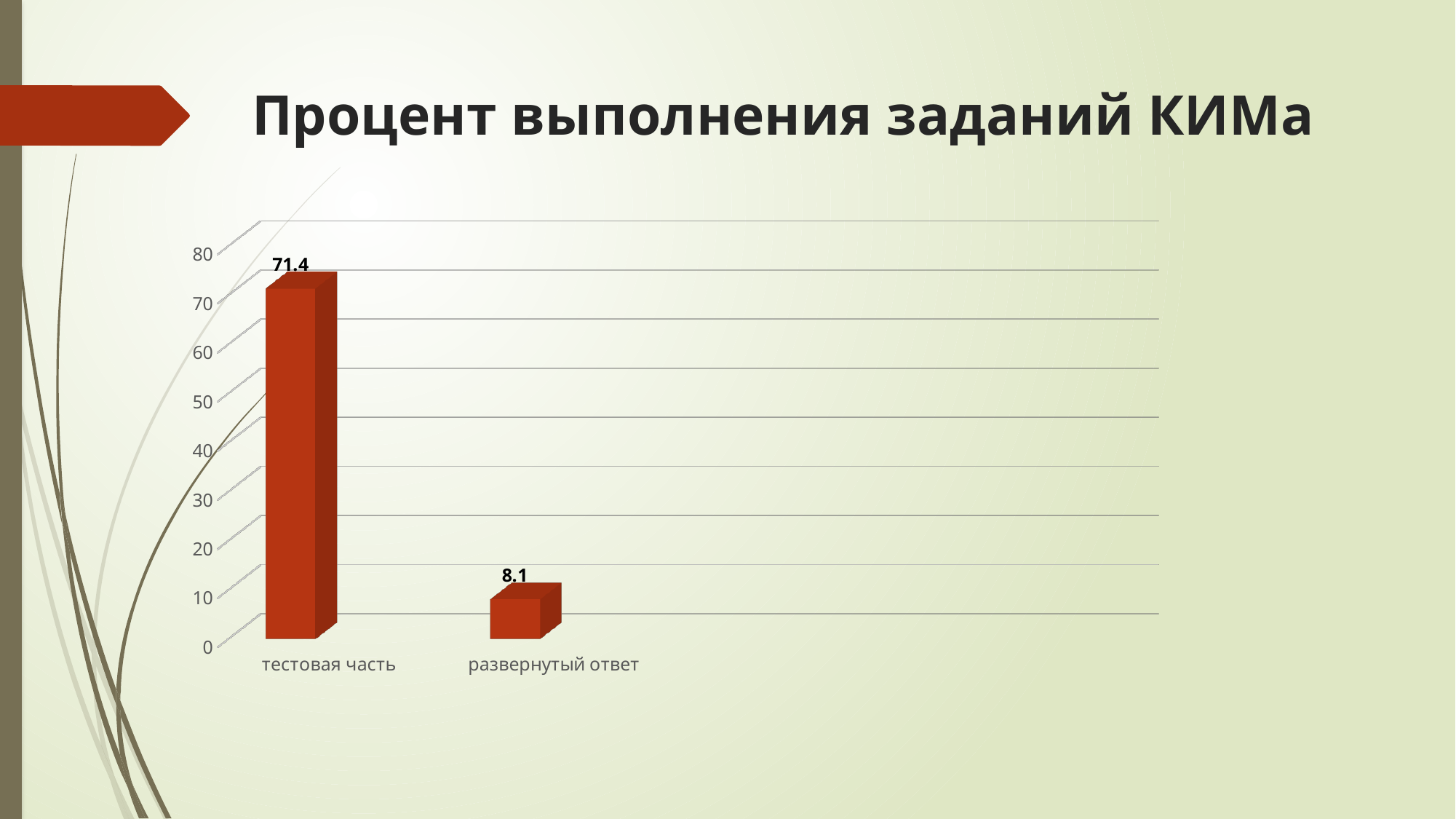
What kind of chart is shown on the slide? bar chart How many categories are shown on the chart? 2 What is the title of the slide? Процент выполнения заданий КИМа Is the value for тестовая часть greater or less than 70? greater What is the difference between the values for тестовая часть and развернутый ответ? 63.3 What is the value for тестовая часть? 71.4 Which category has the highest value? тестовая часть What colour are the bars in the chart? red What is the value for развернутый ответ? 8.1 Which is larger, the value for тестовая часть or the value for развернутый ответ? тестовая часть Which category has the lowest value? развернутый ответ Is the value for развернутый ответ greater or less than 10? less